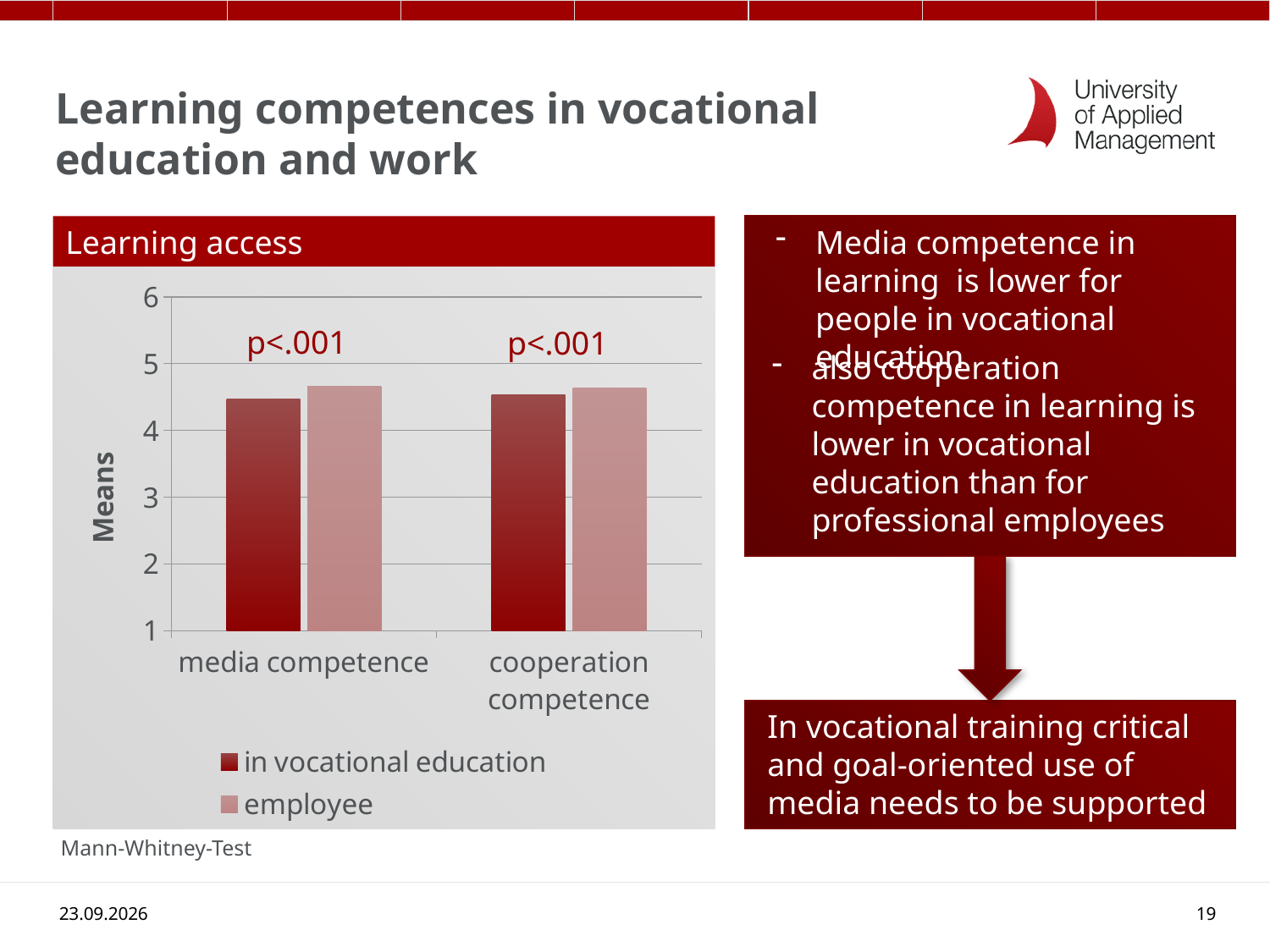
Is the value for "employee" in the cooperation competence category greater or less than 4? greater Is the value for "employee" in the media competence category greater or less than 5? less Is the value for "in vocational education" in the media competence category greater or less than 4? greater How many categories are shown on the x axis of the "Learning access" chart? 2 What kind of chart is shown under the heading "Learning access"? bar chart How many series does the legend of the "Learning access" chart list? 2 What is the label of the y axis in the "Learning access" chart? Means What p-value annotation is printed above each pair of bars in the "Learning access" chart? p<.001 In the media competence category, which series has the larger value: "in vocational education" or "employee"? employee